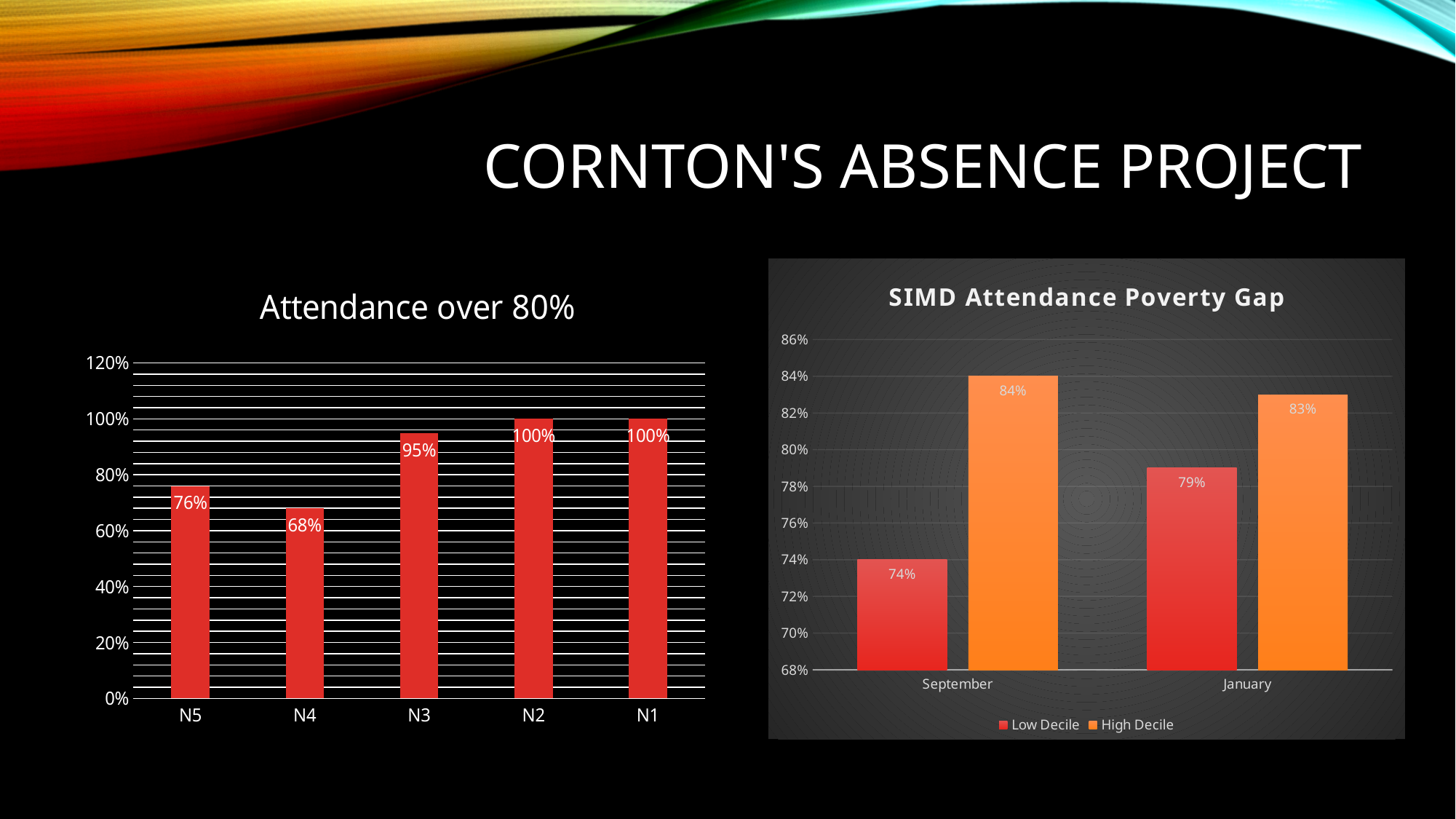
In the 'Attendance over 80%' chart, what is the value for N4? 68% In the 'SIMD Attendance Poverty Gap' chart, what is the difference between the High Decile and Low Decile values for September? 10% In the 'Attendance over 80%' chart, what is the difference between the values for N3 and N5? 19% In the 'Attendance over 80%' chart, how many categories are shown on the x axis? 5 In the 'Attendance over 80%' chart, is the value for N5 greater or less than 80%? less In the 'SIMD Attendance Poverty Gap' chart, what is the Low Decile value for January? 79% In the 'SIMD Attendance Poverty Gap' chart, which is larger: the Low Decile value for September or the Low Decile value for January? January In the 'Attendance over 80%' chart, what is the value for N3? 95% In the 'SIMD Attendance Poverty Gap' chart, how many series does the legend list? 2 In the 'SIMD Attendance Poverty Gap' chart, what is the High Decile value for September? 84% In the 'Attendance over 80%' chart, which category has the lowest value? N4 What kind of chart is the 'SIMD Attendance Poverty Gap' chart? bar chart